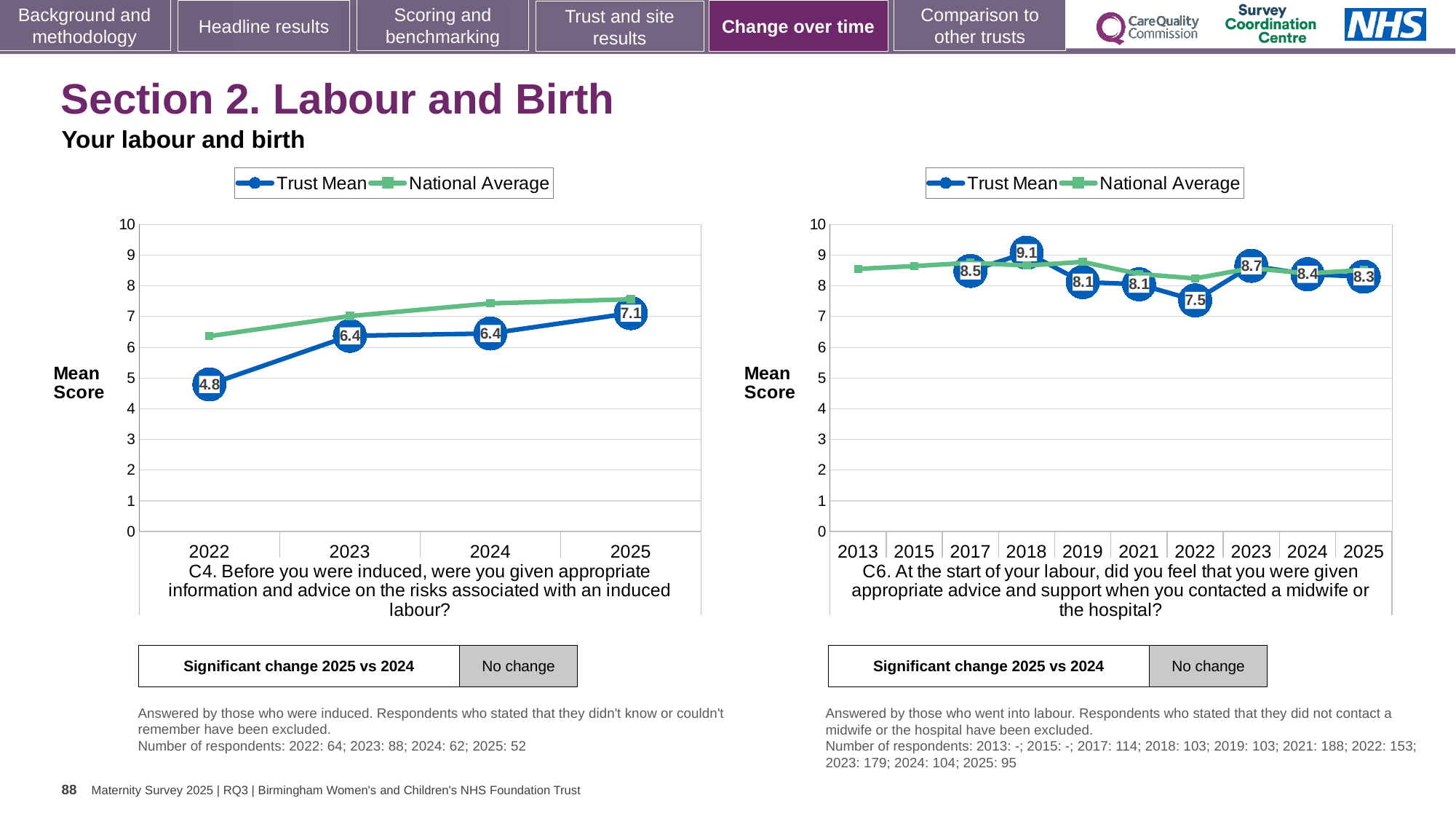
In the left chart (C4), does the Trust Mean generally rise or fall from 2022 to 2025? rise In the left chart (C4), what is the Trust Mean for 2025? 7.1 In the right chart (C6), which year has the lowest Trust Mean? 2022 In the left chart (C4), is the National Average for 2022 greater or less than 6? greater What type of chart is the left chart (C4)? line chart In the left chart (C4), what is the difference between the Trust Mean in 2025 and in 2022? 2.3 In the right chart (C6), which is larger, the Trust Mean for 2023 or for 2025? 2023 In the left chart (C4), which year has the lowest Trust Mean? 2022 In the right chart (C6), what is the Trust Mean for 2018? 9.1 In the left chart (C4), what is the Trust Mean for 2022? 4.8 In the right chart (C6), how many series does the legend list? 2 In the right chart (C6), which year has the highest Trust Mean? 2018